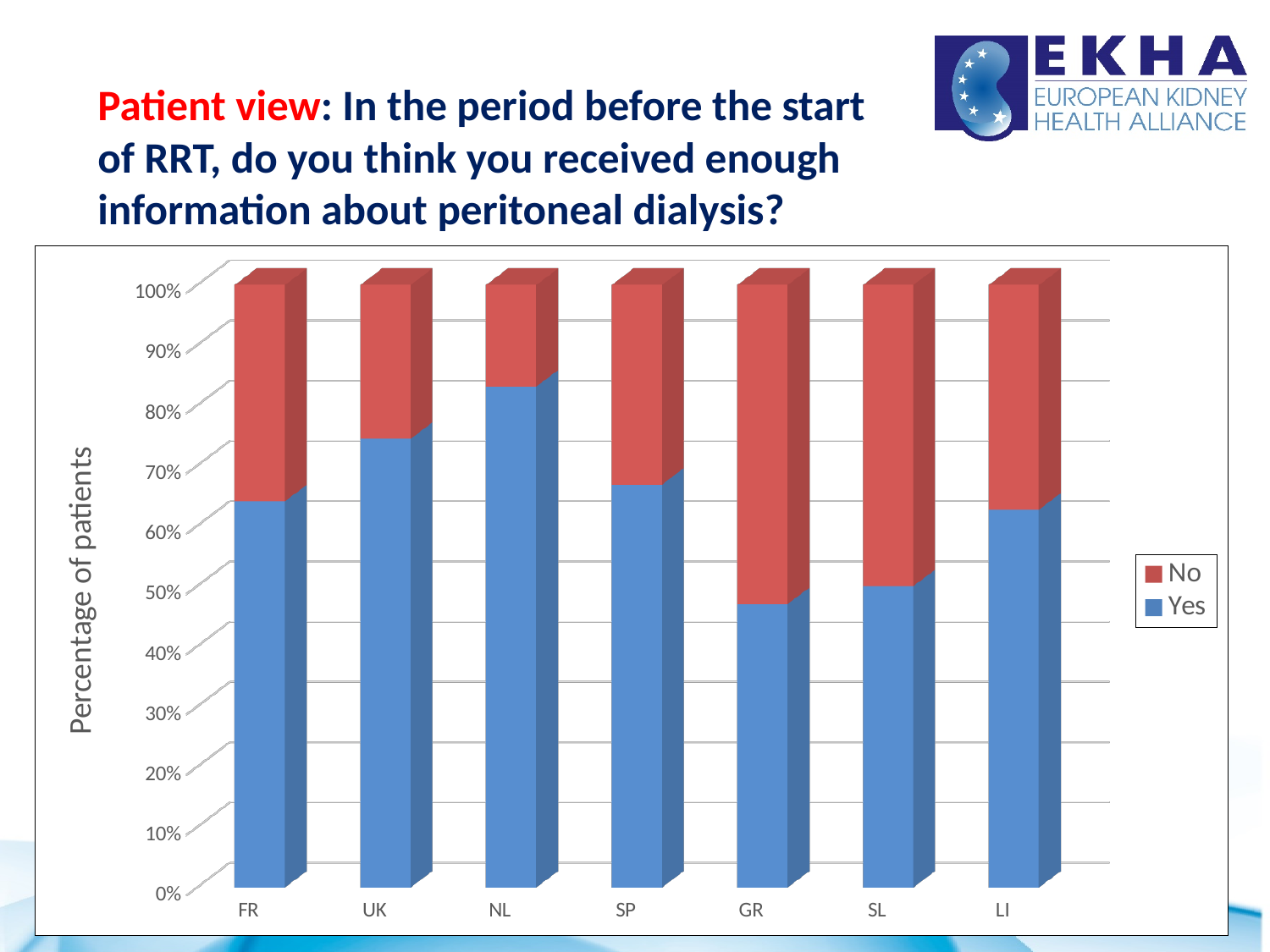
Is the Yes share for FR greater or less than 60%? greater How many countries are shown on the x axis of the chart? 7 Which has the larger No share, GR or FR? GR Which country has the highest share of patients answering Yes? NL What kind of chart is shown on the slide? Stacked bar chart Which has the larger Yes share, NL or UK? NL What is the total height of each stacked bar in the chart? 100% What is the title of the vertical axis of the chart? Percentage of patients Is the Yes share for GR greater or less than 60%? less Is the Yes share for UK greater or less than 70%? greater How many series does the chart legend list? 2